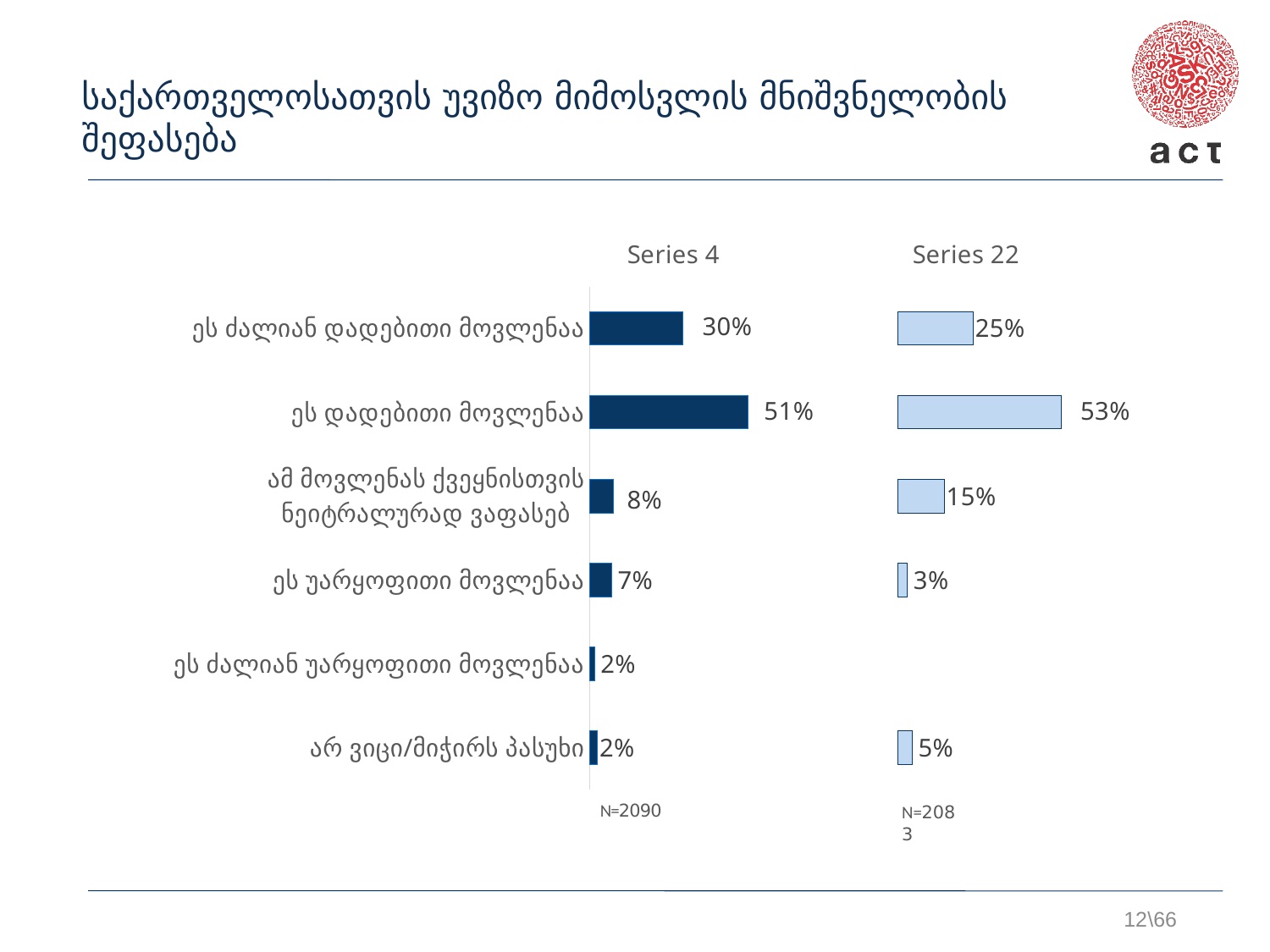
What is the sample size (N) shown under the Series 4 chart? N=2090 In the Series 22 chart, what is the value for ამ მოვლენას ქვეყნისთვის ნეიტრალურად ვაფასებ? 15% In the Series 4 chart, what is the value for არ ვიცი/მიჭირს პასუხი? 2% What is the difference between the Series 22 and Series 4 values for ამ მოვლენას ქვეყნისთვის ნეიტრალურად ვაფასებ? 7% In the Series 4 chart, what is the value for ეს ძალიან დადებითი მოვლენაა? 30% In the Series 4 chart, which category has the highest value? ეს დადებითი მოვლენაა What is the difference between the Series 4 and Series 22 values for ეს ძალიან დადებითი მოვლენაა? 5% For ეს უარყოფითი მოვლენაა, which chart shows the larger value, Series 4 or Series 22? Series 4 How many categories are listed on the left of the charts? 6 What type of chart is used on this slide? Bar chart In the Series 22 chart, what is the value for ეს დადებითი მოვლენაა? 53%